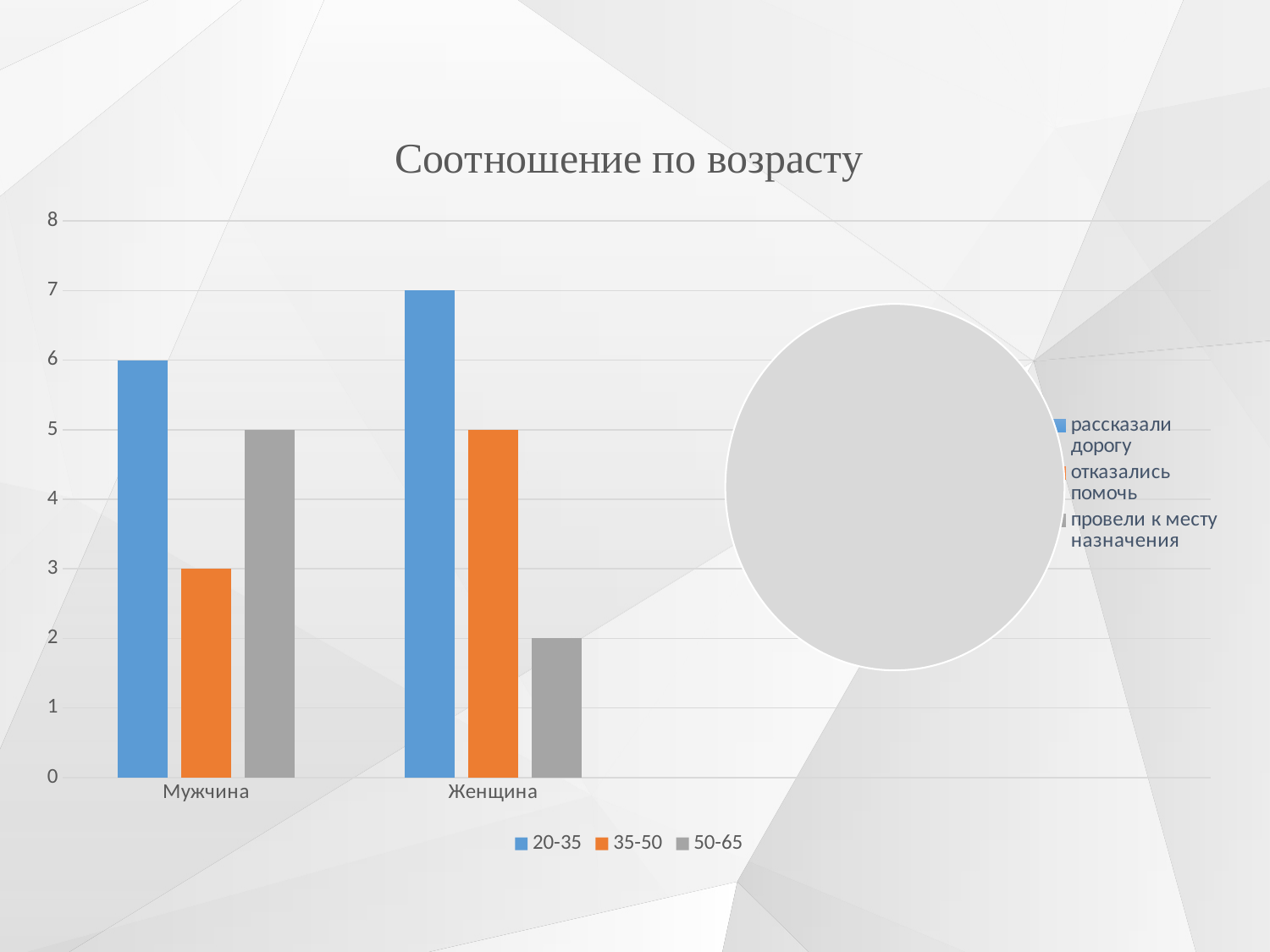
In the chart titled "Соотношение по возрасту", what is the highest value shown on the vertical axis? 8 In the chart titled "Соотношение по возрасту", what is the difference between the 20-35 values for Женщина and Мужчина? 1 In the chart titled "Соотношение по возрасту", which is larger: the 50-65 value for Мужчина or for Женщина? Мужчина In the chart titled "Соотношение по возрасту", what is the value for 20-35 in the Мужчина category? 6 In the chart titled "Соотношение по возрасту", what is the value for 50-65 in the Женщина category? 2 In the chart titled "Соотношение по возрасту", how many categories are shown on the x axis? 2 In the chart titled "Соотношение по возрасту", what is the value for 35-50 in the Женщина category? 5 In the chart titled "Соотношение по возрасту", how many series does the legend list? 3 What kind of chart is the one titled "Соотношение по возрасту"? bar chart In the chart titled "Соотношение по возрасту", which series has the highest value in the Женщина category? 20-35 In the chart titled "Соотношение по возрасту", what is the value for 35-50 in the Мужчина category? 3 In the chart titled "Соотношение по возрасту", which series has the lowest value in the Мужчина category? 35-50